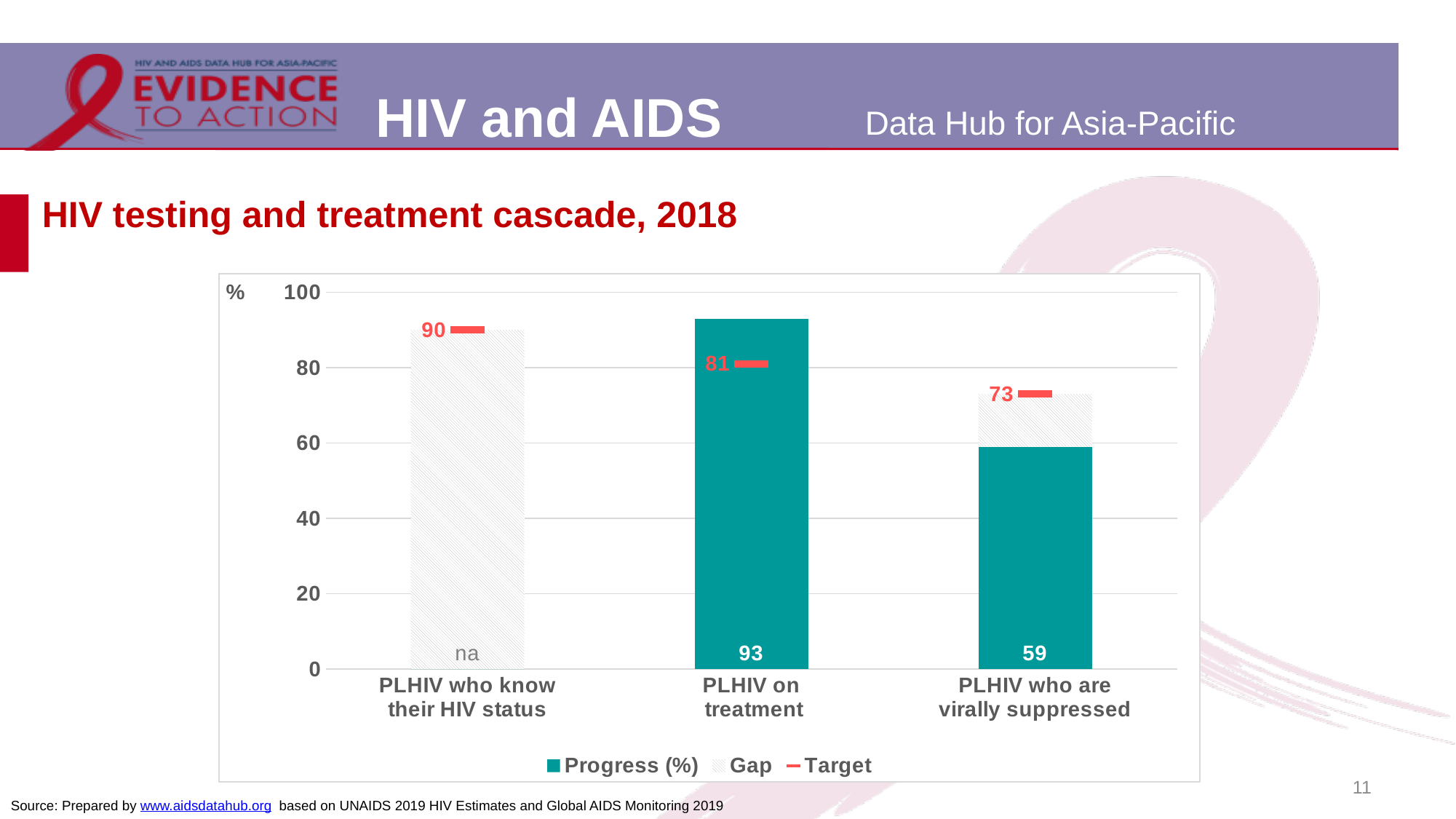
What is the Target value for PLHIV on treatment? 81 How many series does the legend list? 3 Which category has the highest Progress (%) value? PLHIV on treatment What is the Target value for PLHIV who are virally suppressed? 73 What is the Progress (%) value for PLHIV who are virally suppressed? 59 Is the Progress (%) value for PLHIV on treatment greater or less than 80? greater What is the Progress (%) value shown for PLHIV who know their HIV status? na Is the Progress (%) value for PLHIV who are virally suppressed greater or less than its Target of 73? less What type of chart is shown on the slide? bar chart What is the difference between the Progress (%) values for PLHIV on treatment and PLHIV who are virally suppressed? 34 What is the Progress (%) value for PLHIV on treatment? 93 What is the Target value for PLHIV who know their HIV status? 90